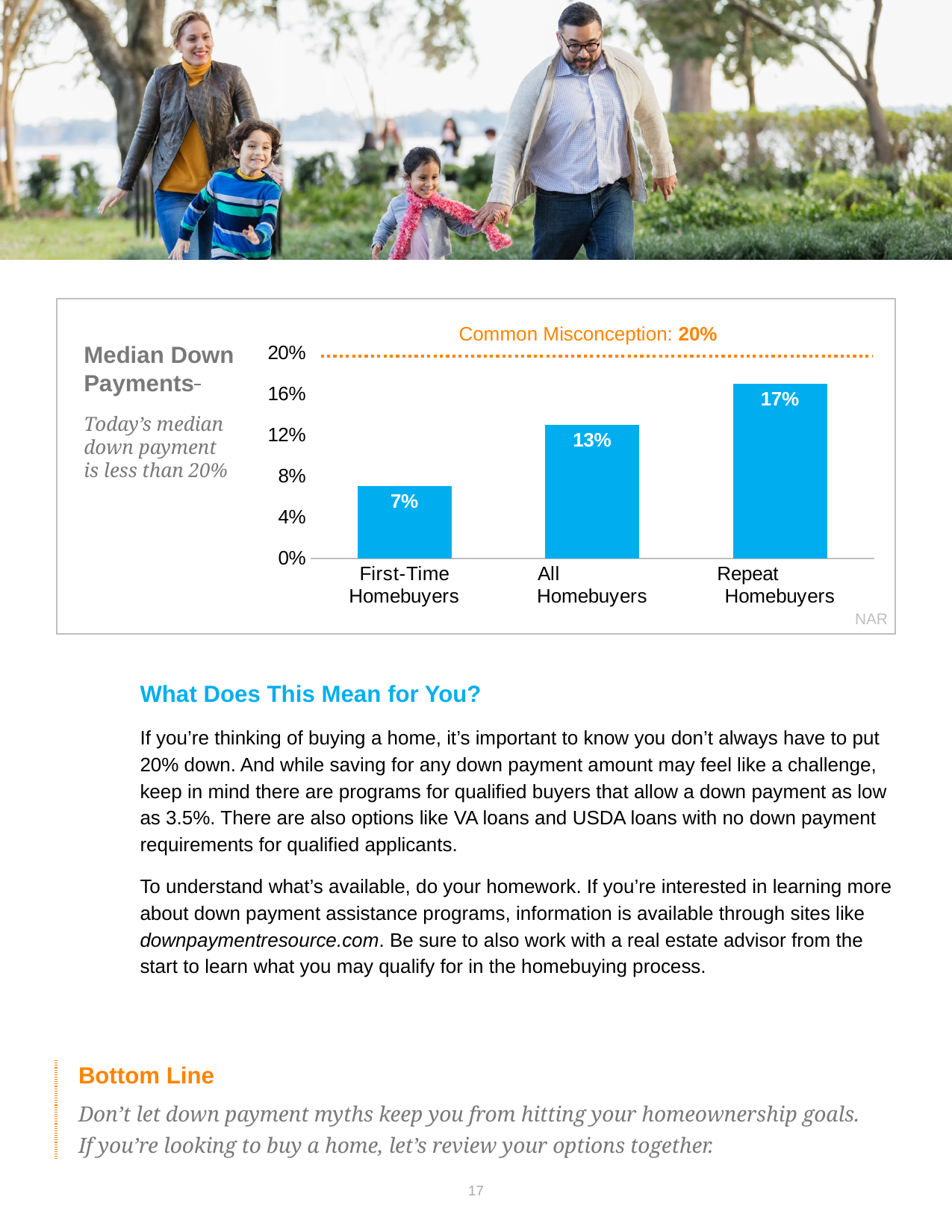
What is the median down payment for First-Time Homebuyers? 7% What is the difference between the median down payment for Repeat Homebuyers and First-Time Homebuyers? 10% Which category has the highest median down payment? Repeat Homebuyers What kind of chart is shown on the slide? Bar chart Which category has the lowest median down payment? First-Time Homebuyers What is the median down payment for Repeat Homebuyers? 17% Is the median down payment for Repeat Homebuyers greater or less than 20%? less What is the median down payment for All Homebuyers? 13% What value does the dotted line labeled 'Common Misconception' mark on the chart? 20% Which is larger, the median down payment for All Homebuyers or for Repeat Homebuyers? Repeat Homebuyers What is the difference between the median down payment for All Homebuyers and First-Time Homebuyers? 6% How many categories are shown in the chart? 3